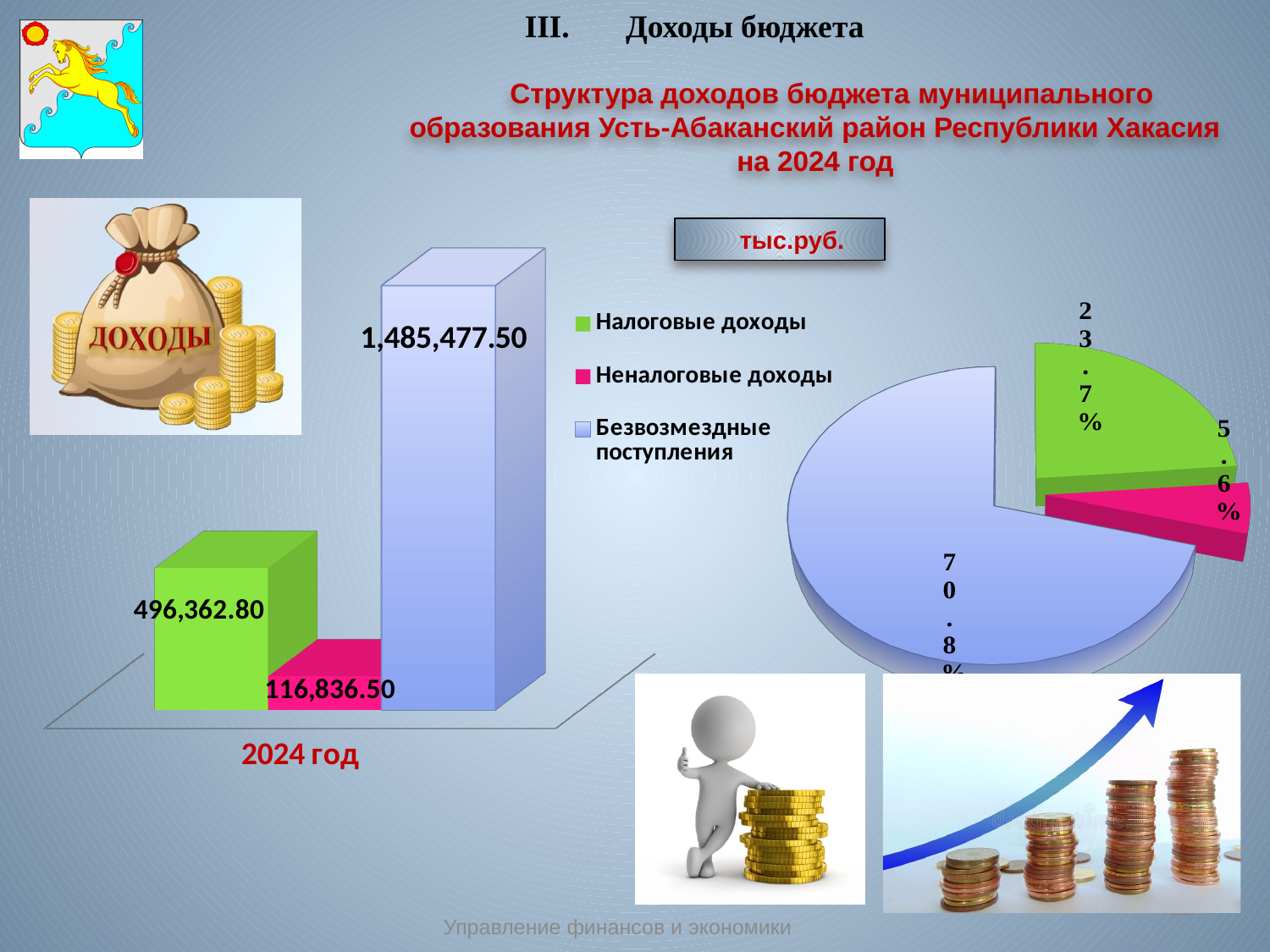
How many series does the legend list? 3 On the bar chart, what is the value for Неналоговые доходы? 116,836.50 On the bar chart, what is the value for Безвозмездные поступления? 1,485,477.50 On the bar chart, which is larger: Налоговые доходы or Неналоговые доходы? Налоговые доходы On the pie chart, what share does the green slice (Налоговые доходы) have? 23.7% On the bar chart, which series has the highest value? Безвозмездные поступления What kind of chart is the chart on the left side of the slide? Bar chart On the bar chart, which series has the lowest value? Неналоговые доходы On the bar chart, what is the value for Налоговые доходы? 496,362.80 On the pie chart, what share does the pink slice (Неналоговые доходы) have? 5.6% On the bar chart, what is the difference between Налоговые доходы and Неналоговые доходы? 379,526.30 What year is shown as the category label under the bar chart? 2024 год